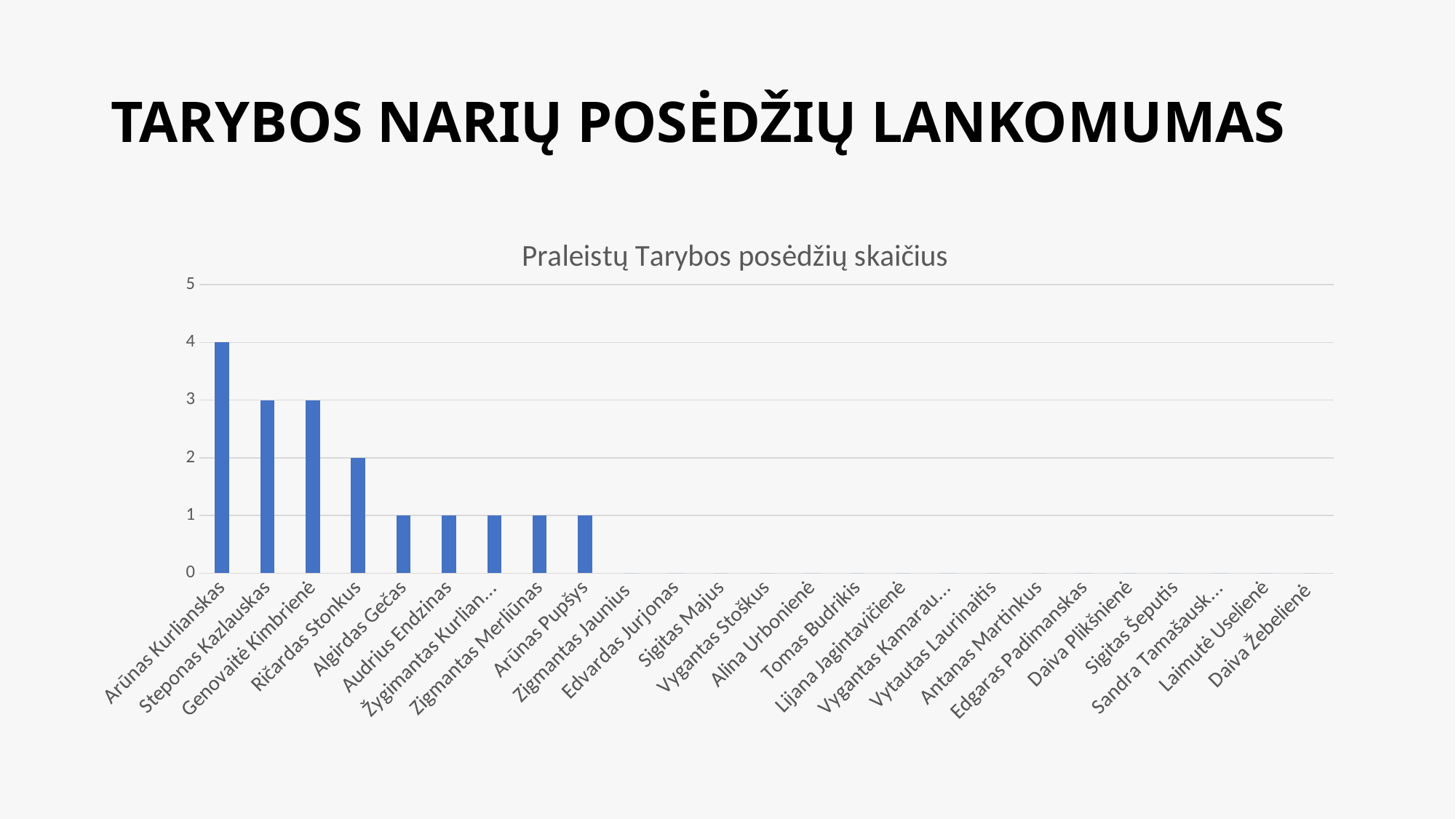
Which council member has the highest number of missed meetings? Arūnas Kurlianskas Which is larger, the value for Genovaitė Kimbrienė or the value for Algirdas Gečas? Genovaitė Kimbrienė What is the value for Arūnas Pupšys? 1 What is the difference between the values for Arūnas Kurlianskas and Ričardas Stonkus? 2 What is the title of the chart? Praleistų Tarybos posėdžių skaičius What kind of chart is shown on the slide? bar chart What is the value for Arūnas Kurlianskas? 4 How many council members are listed on the x axis? 25 What is the value for Steponas Kazlauskas? 3 How many council members have a bar greater than zero? 9 Do the values rise or fall from left to right along the x axis? fall What is the value for Ričardas Stonkus? 2